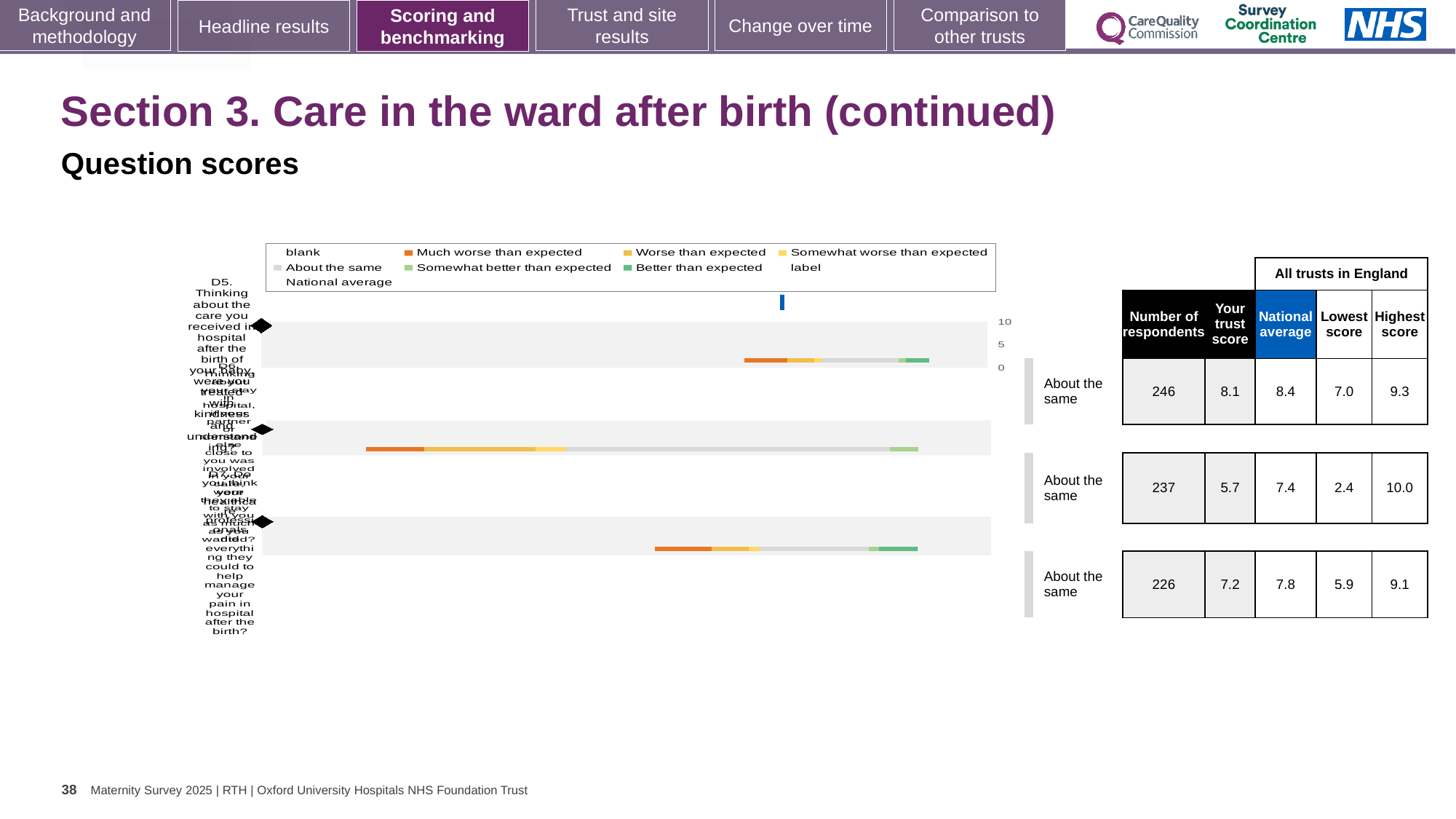
According to the table beside the chart, what is the trust score for the first question row (D5)? 8.1 Which legend entry is shown in dark green? Better than expected Is the trust score for the first question row larger or smaller than its national average? smaller Which legend entry is shown in dark orange? Much worse than expected Which question row has the highest number of respondents in the table beside the chart? the first row (246) Which question row has the lowest trust score in the table beside the chart? the second row (5.7) According to the table beside the chart, what is the number of respondents for the third question row? 226 What benchmark category is shown for all three question rows? About the same According to the table beside the chart, what is the national average for the second question row? 7.4 How many question rows (bars) does the chart show? 3 What is the difference between the national average and the trust score for the second question row? 1.7 What kind of chart is shown on the slide? bar chart